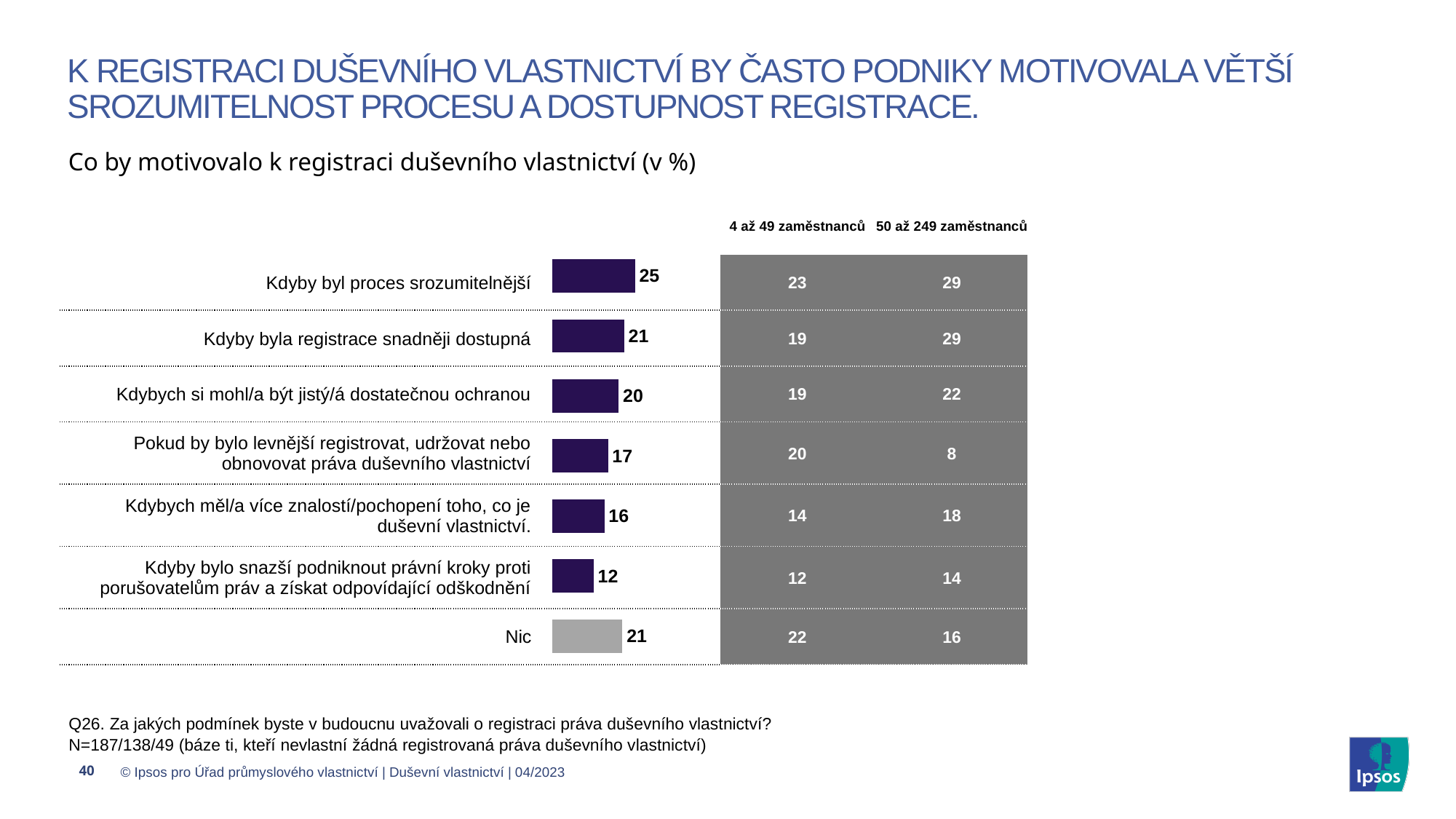
Which is larger: the value for "Pokud by bylo levnější registrovat, udržovat nebo obnovovat práva duševního vlastnictví" or for "Kdybych měl/a více znalostí/pochopení toho, co je duševní vlastnictví."? Pokud by bylo levnější registrovat, udržovat nebo obnovovat práva duševního vlastnictví In the table, what is the value for "Pokud by bylo levnější registrovat, udržovat nebo obnovovat práva duševního vlastnictví" among companies with 4 až 49 zaměstnanců? 20 In the table, what is the value for "Kdyby byla registrace snadněji dostupná" among companies with 50 až 249 zaměstnanců? 29 What kind of chart is shown on the slide? bar chart What is the value for "Kdyby byl proces srozumitelnější" in the bar chart? 25 Which category has the lowest value in the bar chart? Kdyby bylo snazší podniknout právní kroky proti porušovatelům práv a získat odpovídající odškodnění What is the value for "Nic" in the bar chart? 21 How many categories are shown in the bar chart? 7 What is the difference between the values for "Kdyby byl proces srozumitelnější" and "Kdyby byla registrace snadněji dostupná"? 4 Which bar in the chart is coloured grey rather than dark purple? Nic Which category has the highest value in the bar chart? Kdyby byl proces srozumitelnější What is the value for "Kdybych si mohl/a být jistý/á dostatečnou ochranou"? 20